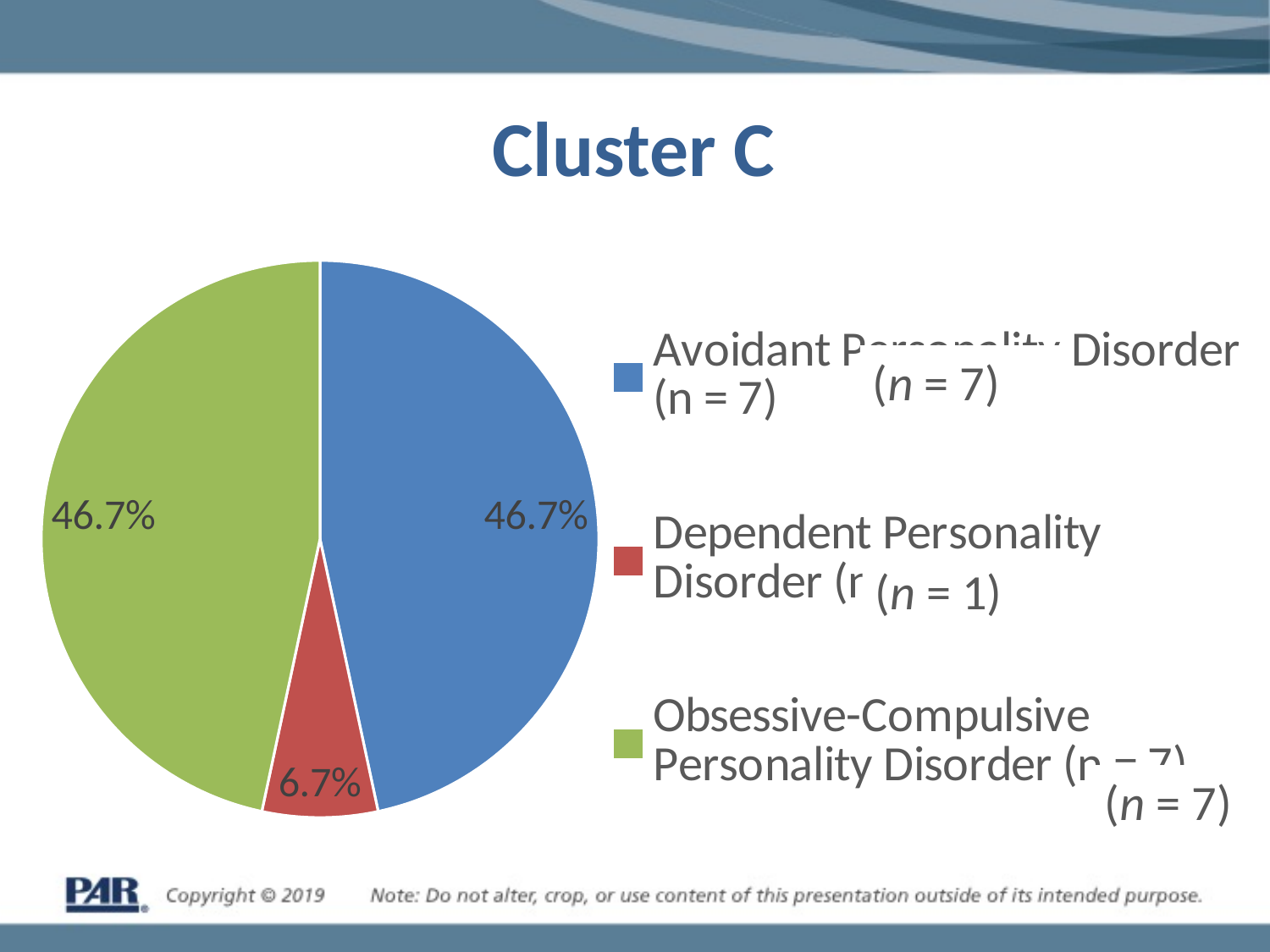
What is the sample size (n) shown in the legend for Dependent Personality Disorder? n = 1 What percentage of the pie is Obsessive-Compulsive Personality Disorder? 46.7% What is the difference in percentage points between the Obsessive-Compulsive Personality Disorder slice and the Dependent Personality Disorder slice? 40.0 percentage points How many slices does the pie chart have? 3 What kind of chart is shown on the slide? Pie chart What colour is the slice for Dependent Personality Disorder? Red Which is larger, the slice for Avoidant Personality Disorder or the slice for Dependent Personality Disorder? Avoidant Personality Disorder What is the title of the chart? Cluster C What percentage of the pie is Avoidant Personality Disorder? 46.7% How many entries does the legend list? 3 Which category has the smallest slice of the pie? Dependent Personality Disorder What percentage of the pie is Dependent Personality Disorder? 6.7%